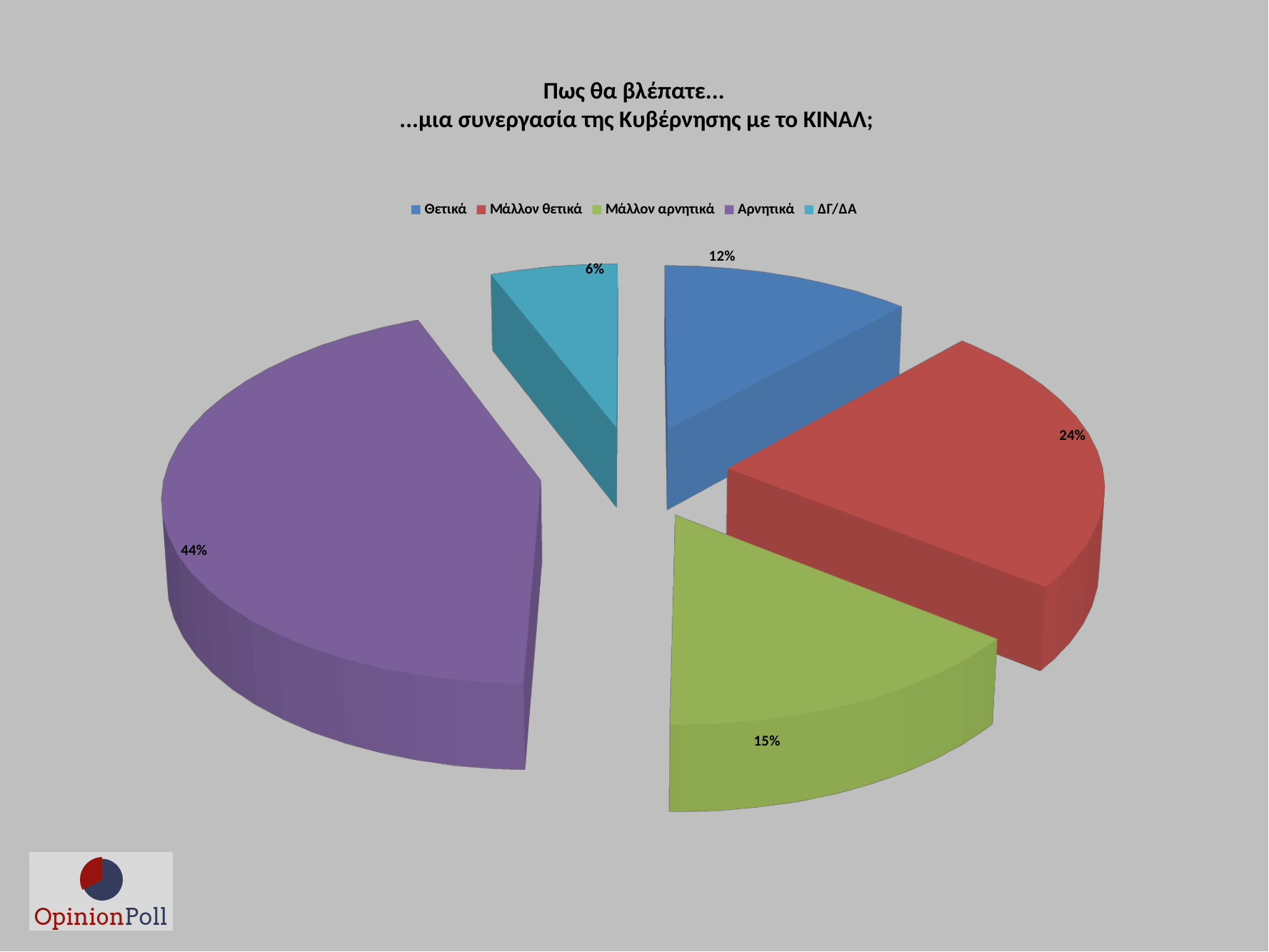
Which response has the largest share of the pie? Αρνητικά What percentage of respondents answered Αρνητικά? 44% How many categories does the legend list? 5 What percentage of respondents answered ΔΓ/ΔΑ? 6% Which response has the smallest share of the pie? ΔΓ/ΔΑ What percentage of respondents answered Θετικά? 12% Which is larger, the share for Μάλλον θετικά or the share for Μάλλον αρνητικά? Μάλλον θετικά What percentage of respondents answered Μάλλον αρνητικά? 15% What kind of chart is shown on the slide? Pie chart What colour is the slice for Αρνητικά? Purple What is the difference in percentage points between Αρνητικά and Μάλλον θετικά? 20 What percentage of respondents answered Μάλλον θετικά? 24%